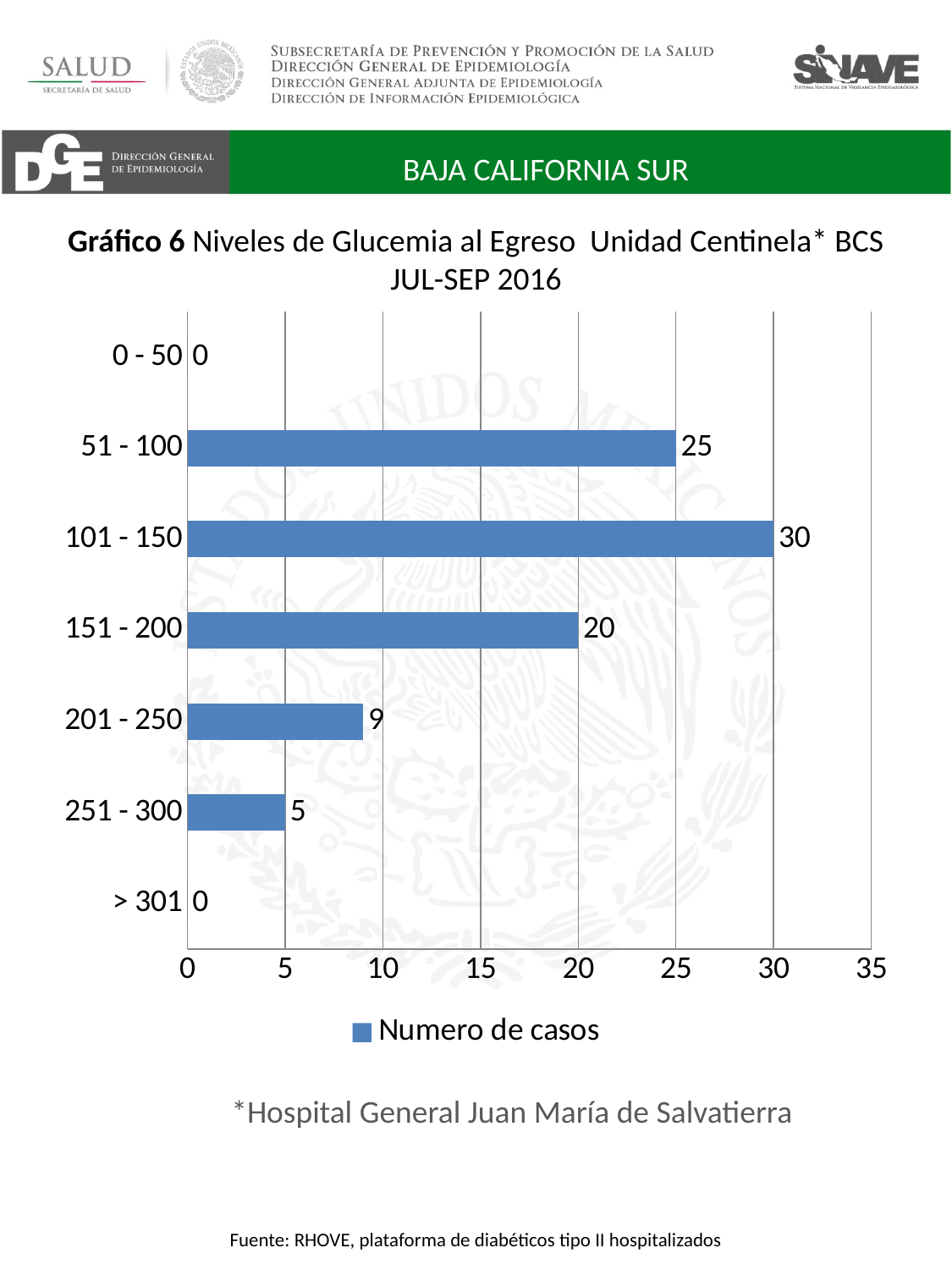
Which glucose level category has the highest number of cases? 101 - 150 What is the number of cases for the 51 - 100 category? 25 Which categories have 0 cases? 0 - 50 and > 301 What is the number of cases for the 101 - 150 glucose level category? 30 What is the number of cases for the 201 - 250 category? 9 How many glucose level categories are shown on the chart? 7 What is the number of cases for the 251 - 300 category? 5 Which has more cases, the 51 - 100 category or the 151 - 200 category? 51 - 100 How many series does the legend list? 1 What is the difference in number of cases between the 101 - 150 and 151 - 200 categories? 10 What is the name of the series shown in the legend? Numero de casos What kind of chart is shown on the slide? Bar chart